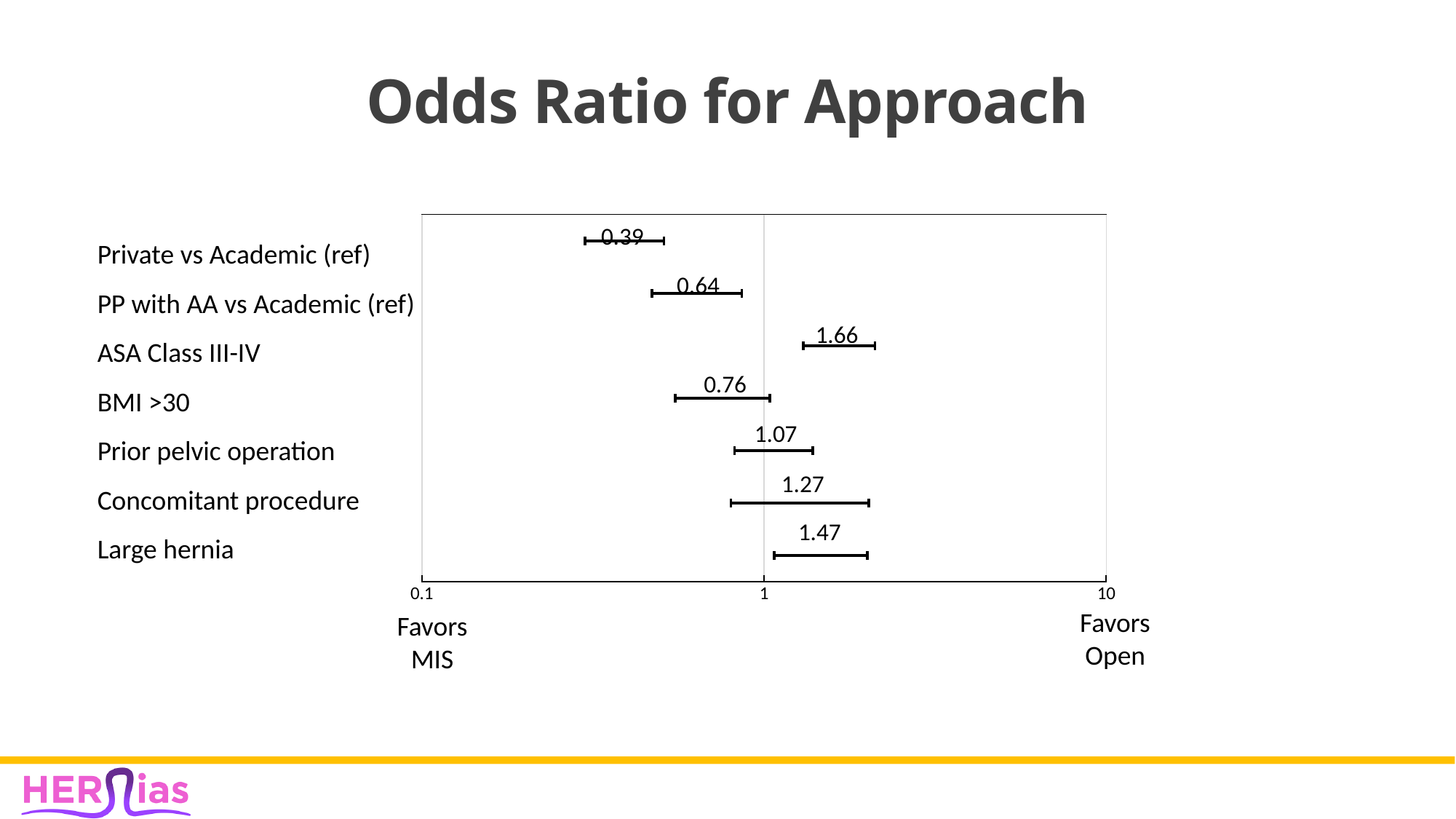
What is the title of the chart? Odds Ratio for Approach What is the odds ratio for ASA Class III-IV? 1.66 Is the odds ratio for PP with AA vs Academic (ref) greater or less than 1? less What is the odds ratio for Large hernia? 1.47 What is the odds ratio for BMI >30? 0.76 Which category has the highest odds ratio? ASA Class III-IV How many categories are plotted on the chart? 7 Which has a larger odds ratio, Concomitant procedure or Prior pelvic operation? Concomitant procedure Which category has the lowest odds ratio? Private vs Academic (ref) What is the odds ratio for Private vs Academic (ref)? 0.39 What label appears at the right end of the x axis? Favors Open What is the difference between the odds ratios for ASA Class III-IV and Large hernia? 0.19